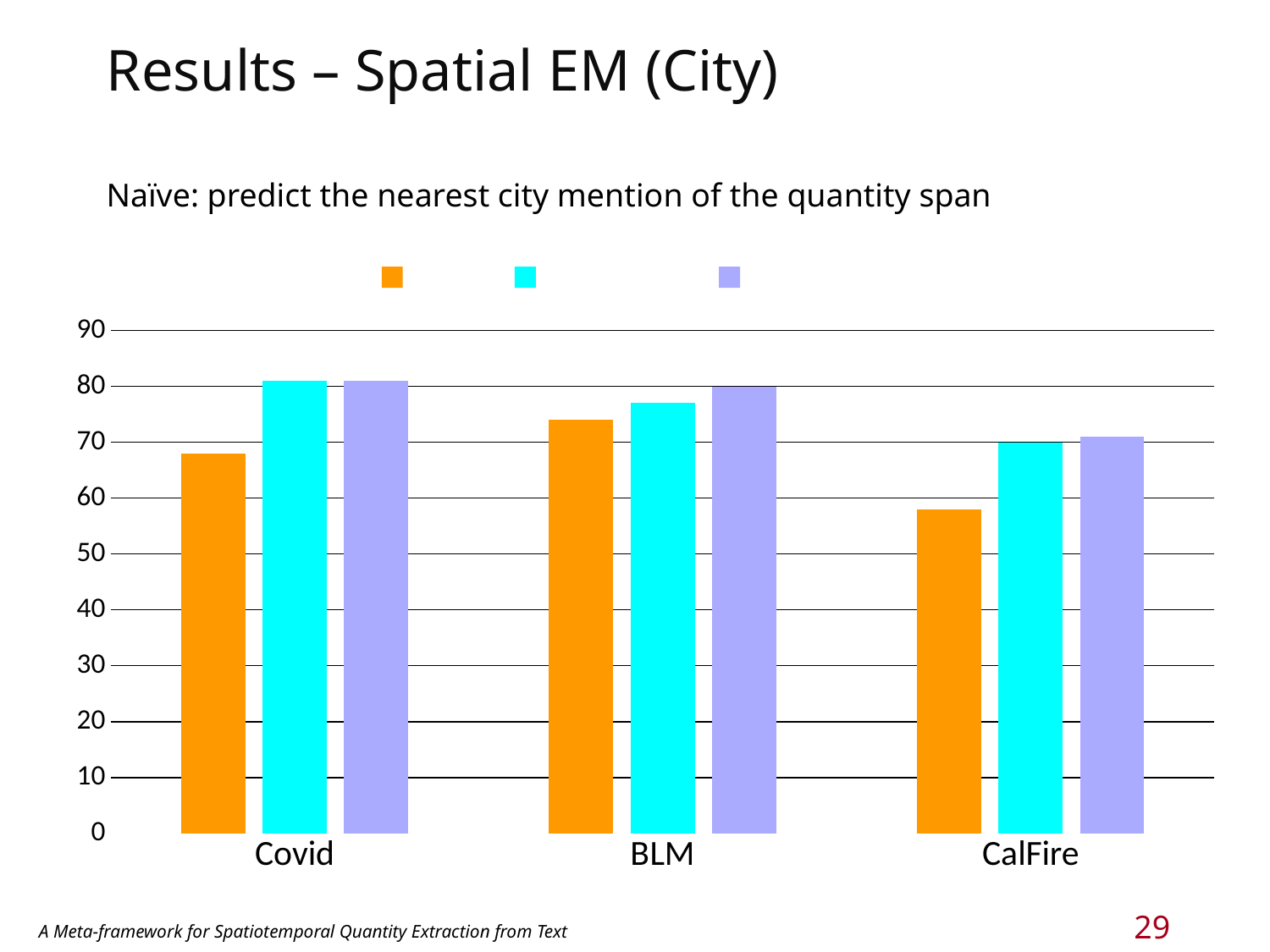
What colour is the first series shown in the chart's legend? orange Do the cyan bars rise or fall from Covid to CalFire along the x axis? fall How many categories are shown on the x axis of the chart? 3 Which category has the highest orange bar? BLM Is the orange bar for BLM greater or less than 70? greater Is the orange bar for CalFire greater or less than 60? less How many series does the chart's legend list? 3 What kind of chart is shown on the slide? bar chart Is the cyan bar for BLM greater or less than 80? less Which is larger, the cyan bar for Covid or the cyan bar for CalFire? Covid Which category has the lowest orange bar? CalFire